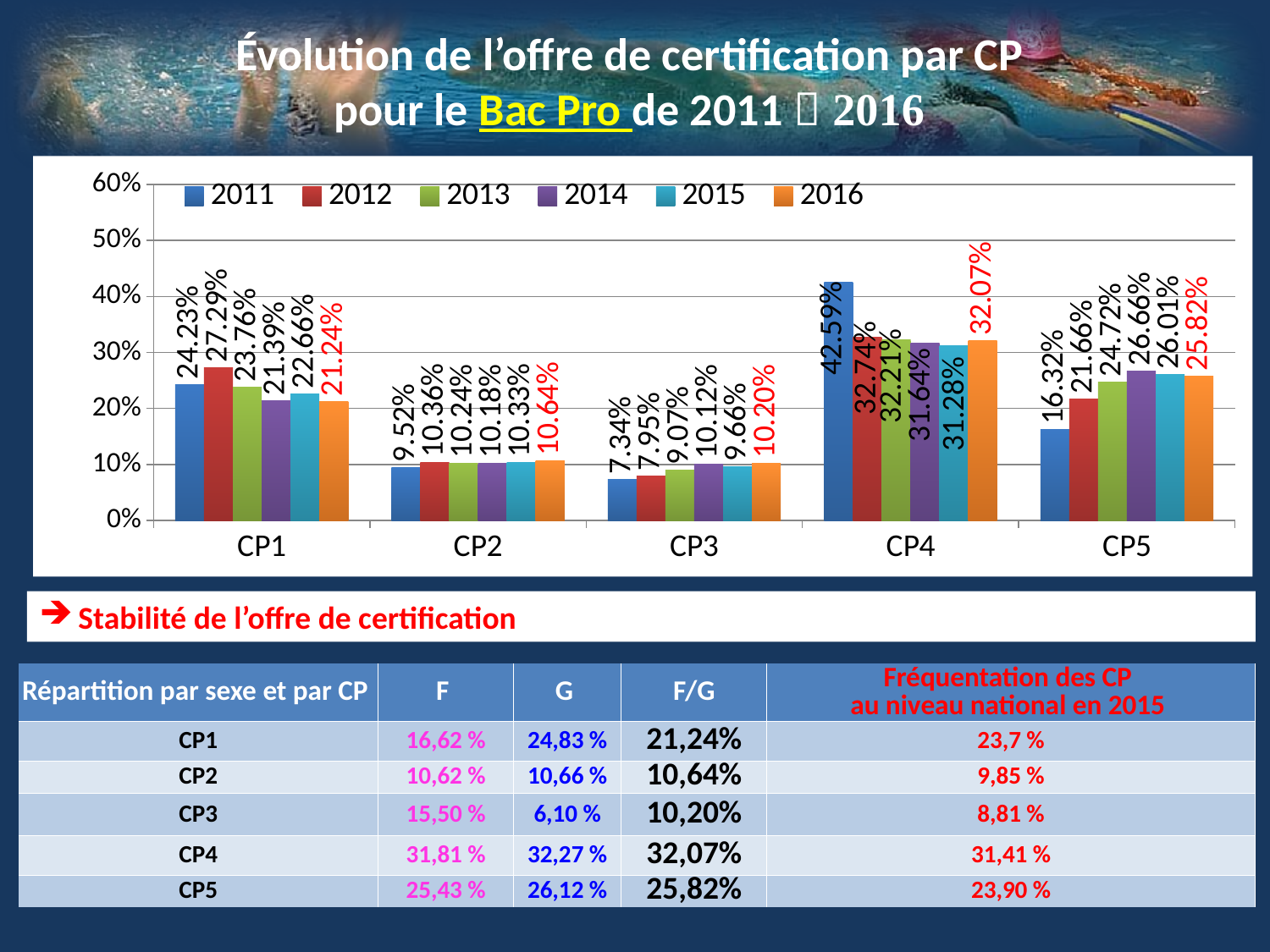
What is the value for CP4 in 2011? 42.59% How many series does the legend list? 6 Which category has the lowest value in 2011? CP3 Which category has the highest value in 2016? CP4 What is the difference between the 2011 and 2012 values for CP4? 9.85 percentage points What kind of chart is shown? bar chart Do the values for CP5 rise or fall from 2011 to 2014? rise What is the value for CP1 in 2016? 21.24% How many categories are shown on the x axis? 5 Is the value for CP4 in 2011 greater or less than 40%? greater Which is larger for CP5: the 2014 value or the 2015 value? 2014 What is the value for CP5 in 2013? 24.72%